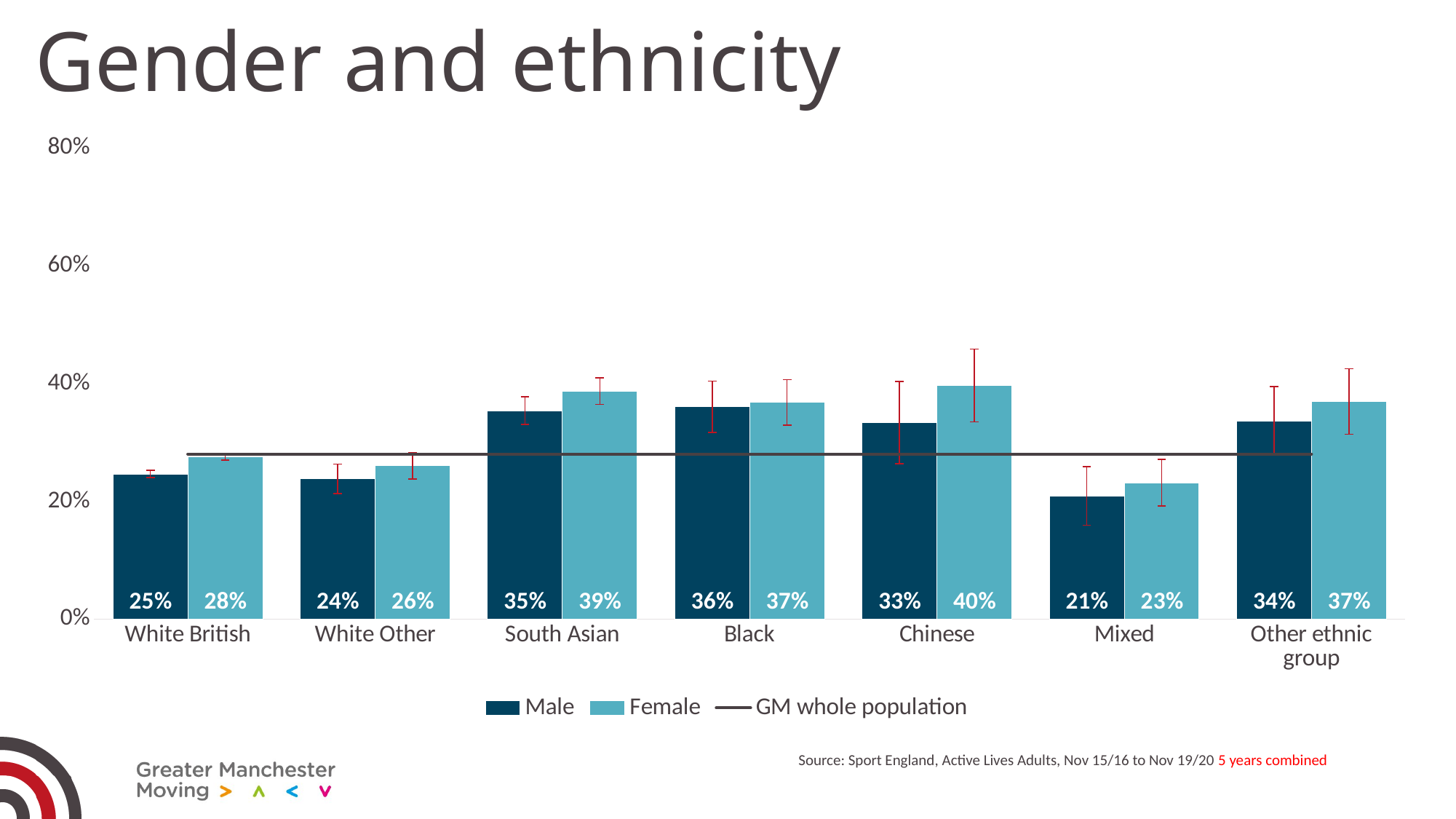
Is the GM whole population line greater or less than 40%? less What is the Male value for Mixed? 21% How many ethnic group categories are shown on the x axis? 7 What is the title of the slide? Gender and ethnicity Which is larger, the Male value for South Asian or the Male value for White British? Male value for South Asian What is the difference between the Female and Male values for Chinese? 7% What is the Female value for Chinese? 40% What is the Male value for Black? 36% Which ethnic group has the lowest Male value? Mixed What kind of chart is shown on the slide? bar chart Which ethnic group has the highest Female value? Chinese How many entries does the legend list? 3